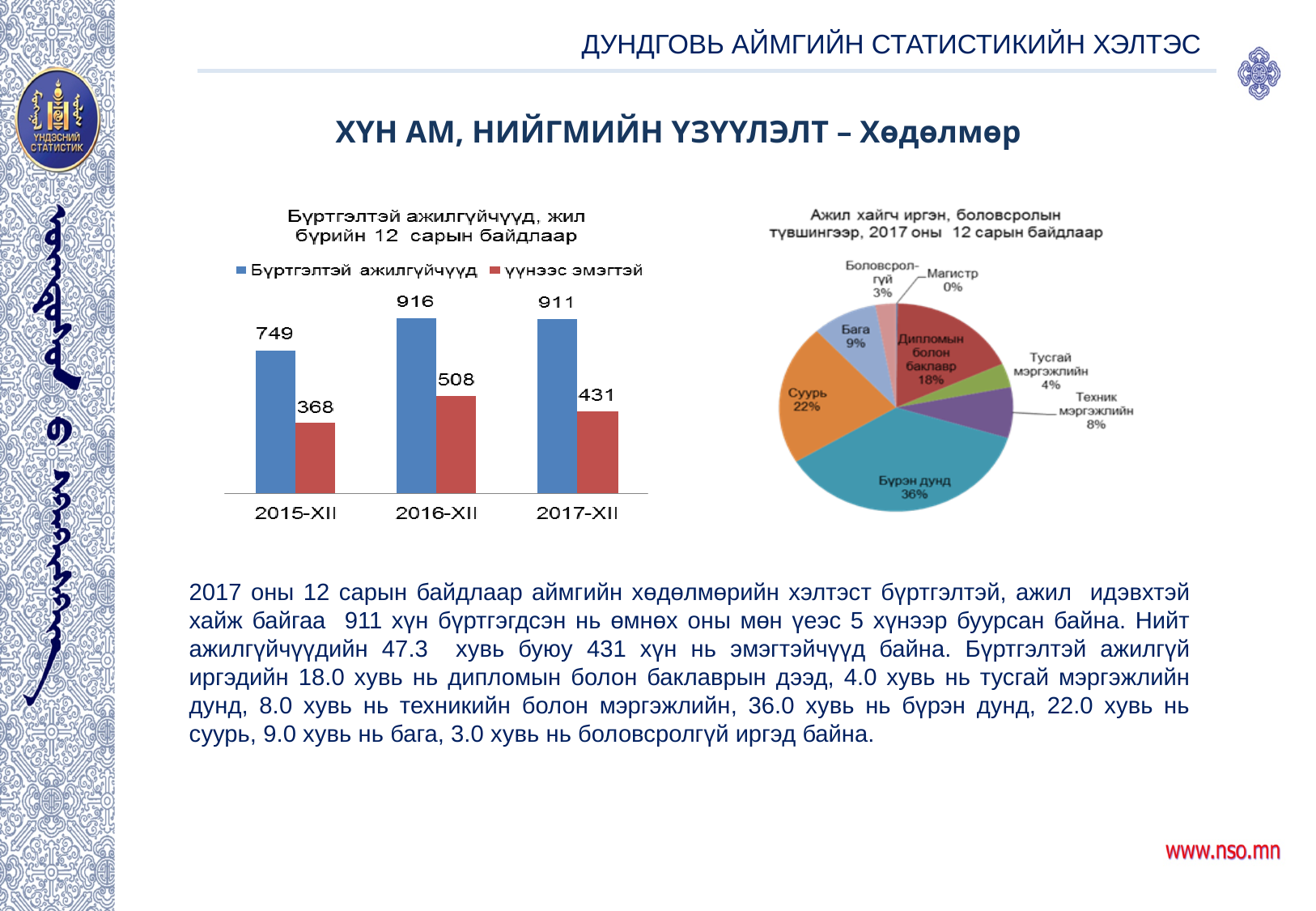
In the bar chart on the left, what is the value of 'Бүртгэлтэй ажилгүйчүүд' for 2016-XII? 916 In the bar chart on the left, which period has the highest value for 'Бүртгэлтэй ажилгүйчүүд'? 2016-XII In the bar chart on the left, what is the value of 'үүнээс эмэгтэй' for 2017-XII? 431 In the bar chart on the left, how many periods are shown on the x axis? 3 In the pie chart on the right, what share does 'Суурь' have? 22% In the pie chart on the right, which is larger: 'Бага' or 'Техник мэргэжлийн'? Бага In the bar chart on the left, which period has the lowest value for 'үүнээс эмэгтэй'? 2015-XII What kind of chart is the chart on the left? Bar chart In the bar chart on the left, how many series does the legend list? 2 In the pie chart on the right, what share does 'Бүрэн дунд' have? 36% In the pie chart on the right, which category has the largest share? Бүрэн дунд In the bar chart on the left, what is the difference between the 'Бүртгэлтэй ажилгүйчүүд' values for 2016-XII and 2017-XII? 5